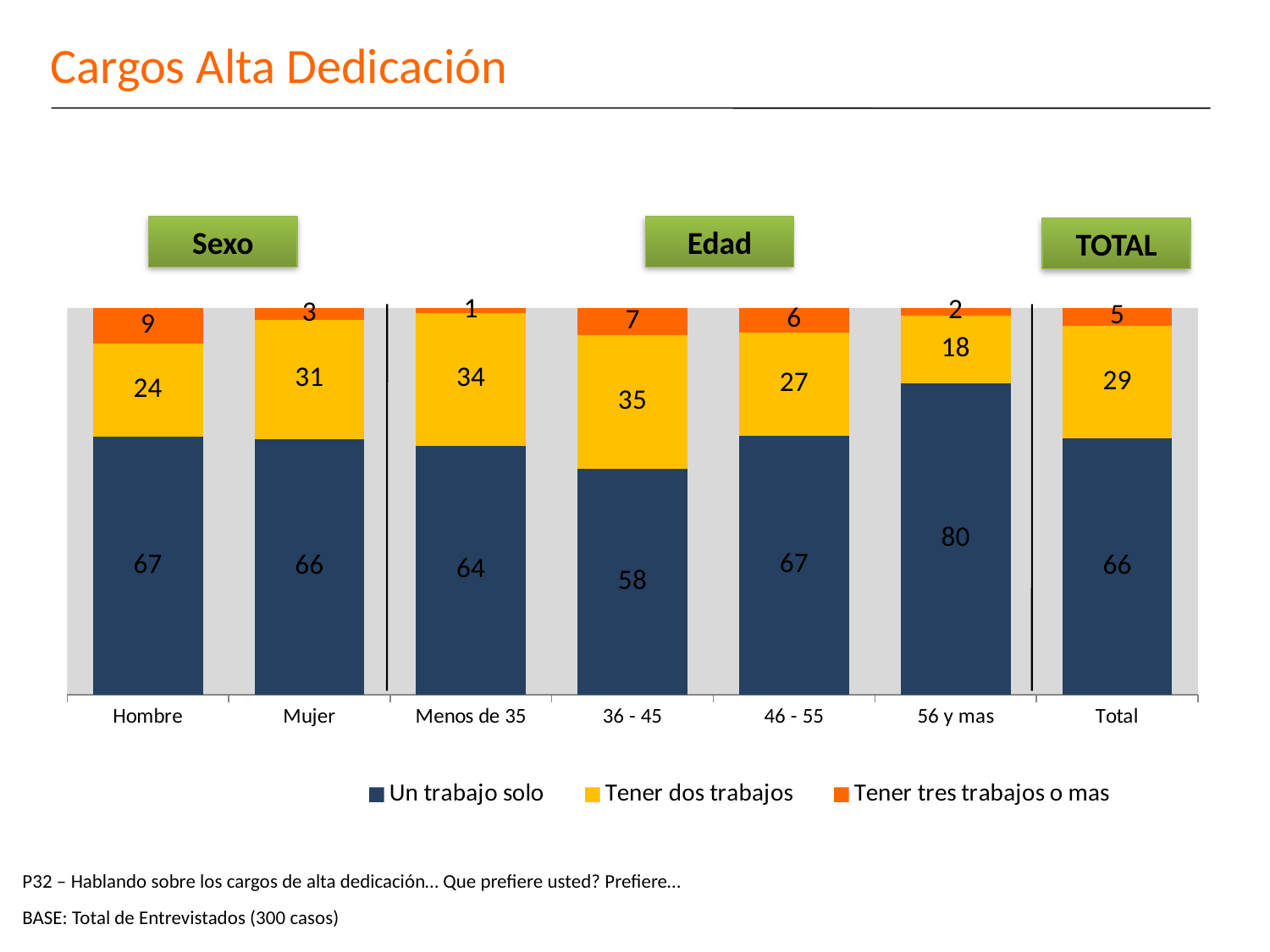
What is the total of the stacked bar for "Total"? 100 Which category has the highest value for "Un trabajo solo"? 56 y mas What is the difference between the "Un trabajo solo" values for "56 y mas" and "36 - 45"? 22 What is the value of "Tener tres trabajos o mas" for "Hombre"? 9 How many series does the legend list? 3 Which series is shown in orange in the legend? Tener tres trabajos o mas What is the value of "Un trabajo solo" for the "56 y mas" category? 80 How many categories are shown on the x axis? 7 What is the value of "Tener dos trabajos" for "Mujer"? 31 What kind of chart is shown on the slide? Stacked bar chart Which category has the lowest value for "Un trabajo solo"? 36 - 45 Which is larger: the "Tener dos trabajos" value for "Hombre" or for "Mujer"? Mujer